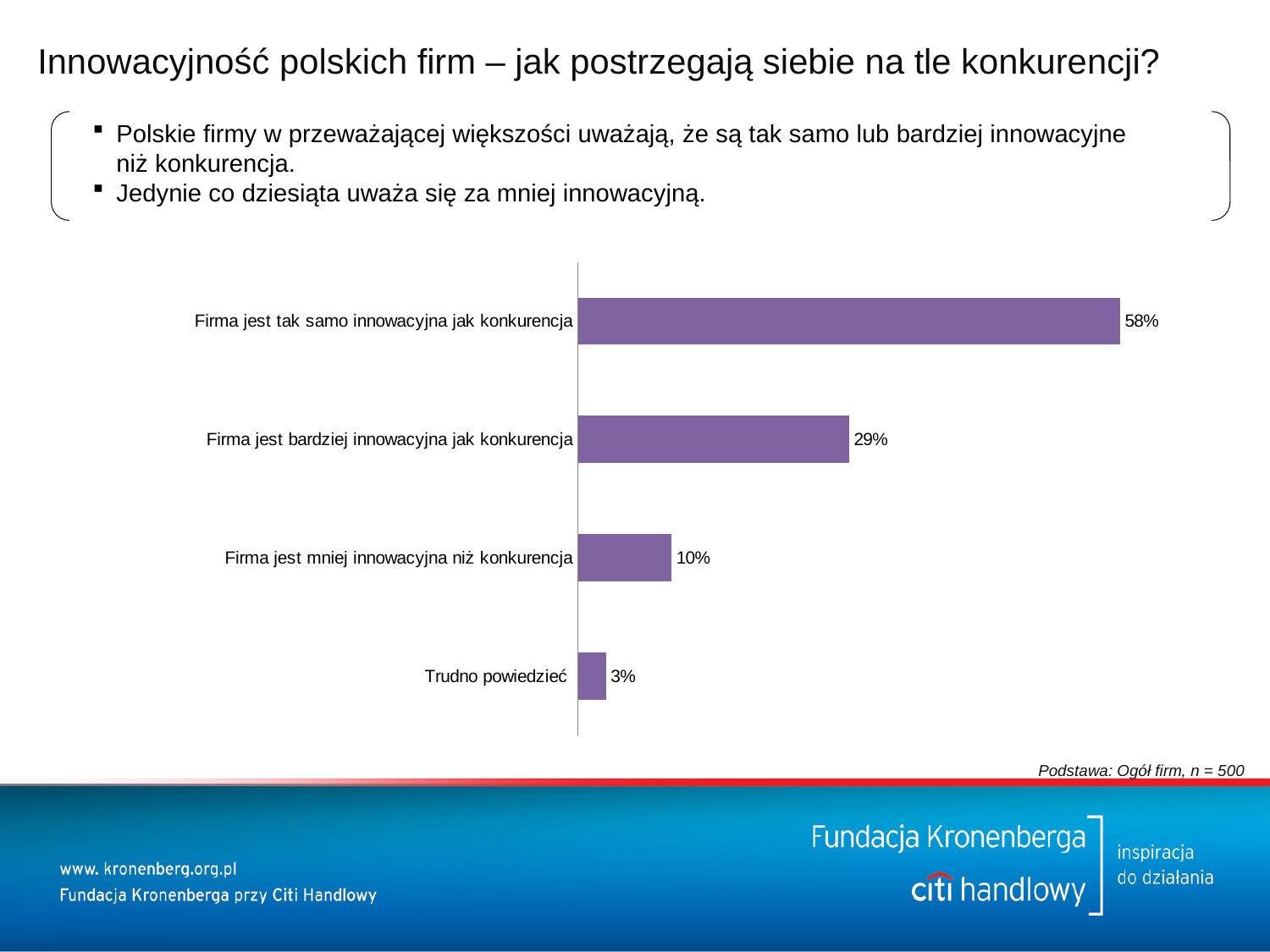
What kind of chart is shown on the slide? Bar chart What is the difference between the values for "Firma jest tak samo innowacyjna jak konkurencja" and "Firma jest bardziej innowacyjna jak konkurencja"? 29% Which category has the lowest value? Trudno powiedzieć What is the value for "Firma jest mniej innowacyjna niż konkurencja"? 10% What is the value for "Firma jest bardziej innowacyjna jak konkurencja"? 29% What colour are the bars in the chart? Purple What is the value for "Trudno powiedzieć"? 3% What is the value for "Firma jest tak samo innowacyjna jak konkurencja"? 58% Which category has the highest value? Firma jest tak samo innowacyjna jak konkurencja Which is larger: the value for "Firma jest bardziej innowacyjna jak konkurencja" or "Firma jest mniej innowacyjna niż konkurencja"? Firma jest bardziej innowacyjna jak konkurencja What is the difference between the values for "Firma jest mniej innowacyjna niż konkurencja" and "Trudno powiedzieć"? 7% How many categories are shown in the chart? 4